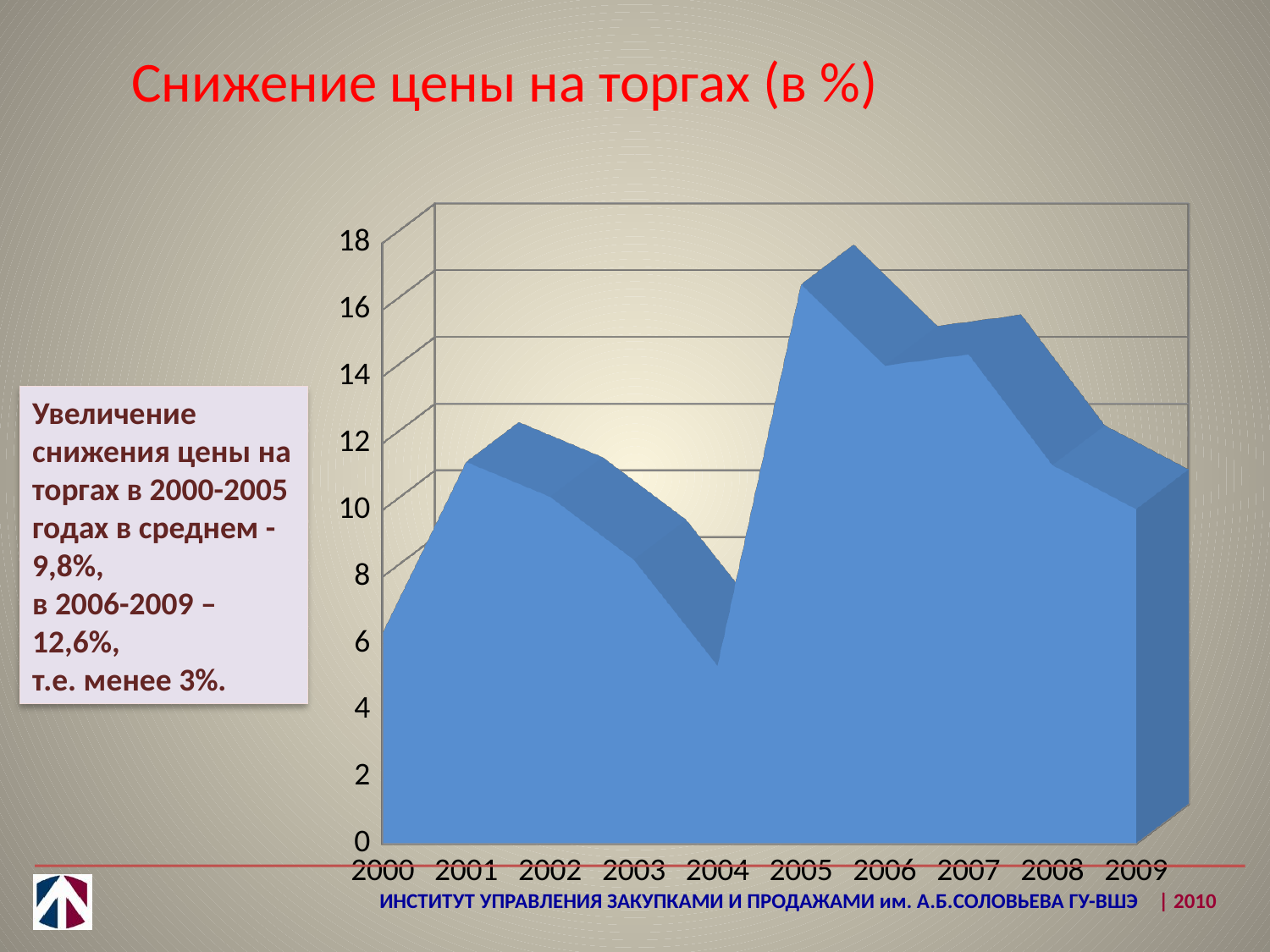
Is the value for 2006 greater or less than 12? greater Which year has the larger value, 2003 or 2008? 2008 What is the title of the chart? Снижение цены на торгах (в %) Is the value for 2004 greater or less than 8? less Which year has the lowest value in the chart? 2004 Is the value for 2005 greater or less than 14? greater Which year has the larger value, 2004 or 2005? 2005 Which year has the highest value in the chart? 2005 How many years are plotted along the x axis of the chart? 10 What kind of chart is shown on the slide? Area chart Do the values rise or fall from 2005 to 2009? fall